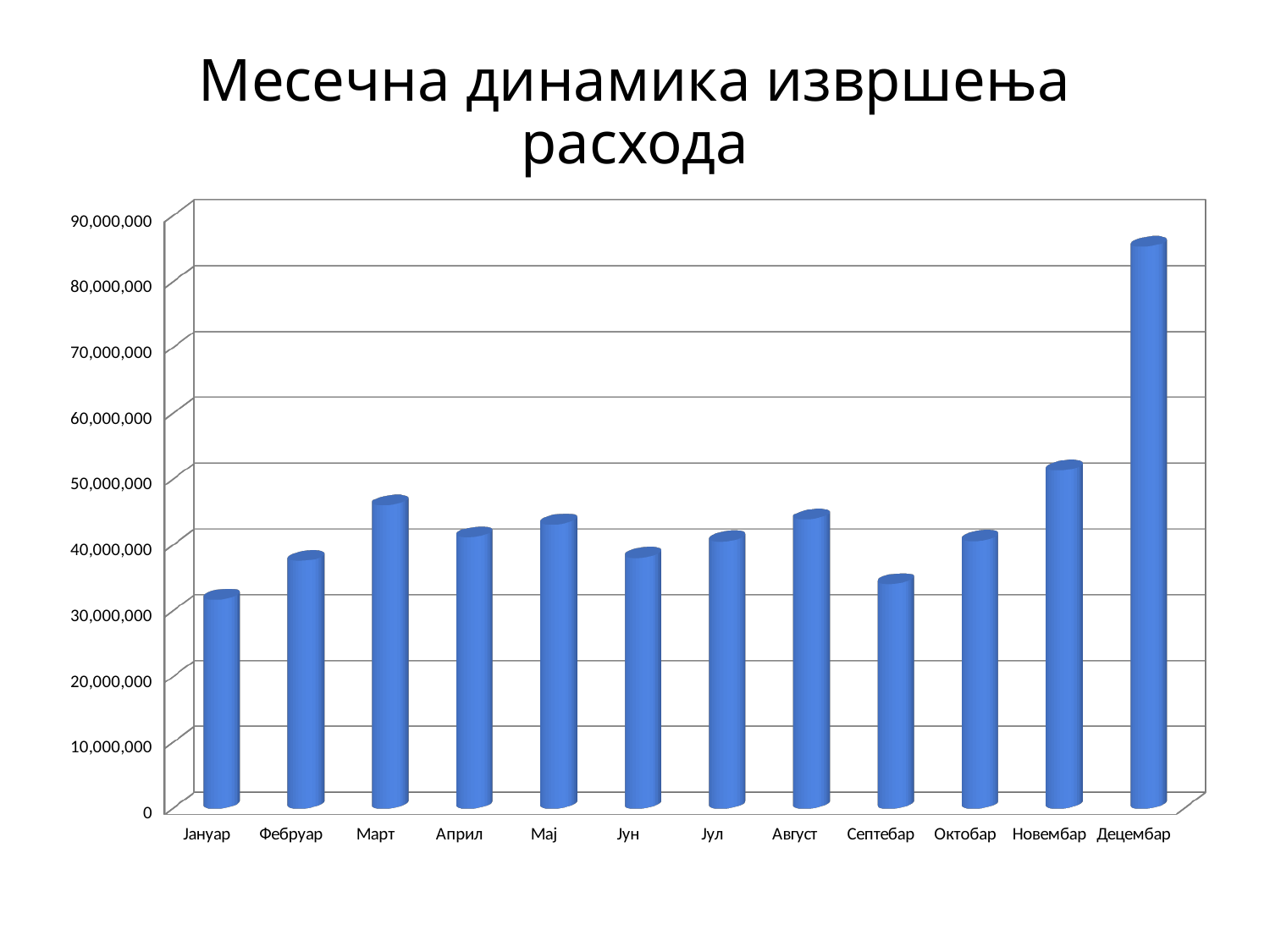
What is the title of the chart? Месечна динамика извршења расхода Is the value for Децембар greater or less than 80,000,000? greater Is the value for Новембар greater or less than 60,000,000? less Which month has the highest value? Децембар How many months (categories) are shown on the x axis? 12 What kind of chart is shown on the slide? bar chart Which month has the lowest value? Јануар Is the value for Јануар greater or less than 40,000,000? less Do the values rise or fall from Септебар to Децембар? rise Which is larger, the value for Март or the value for Април? Март